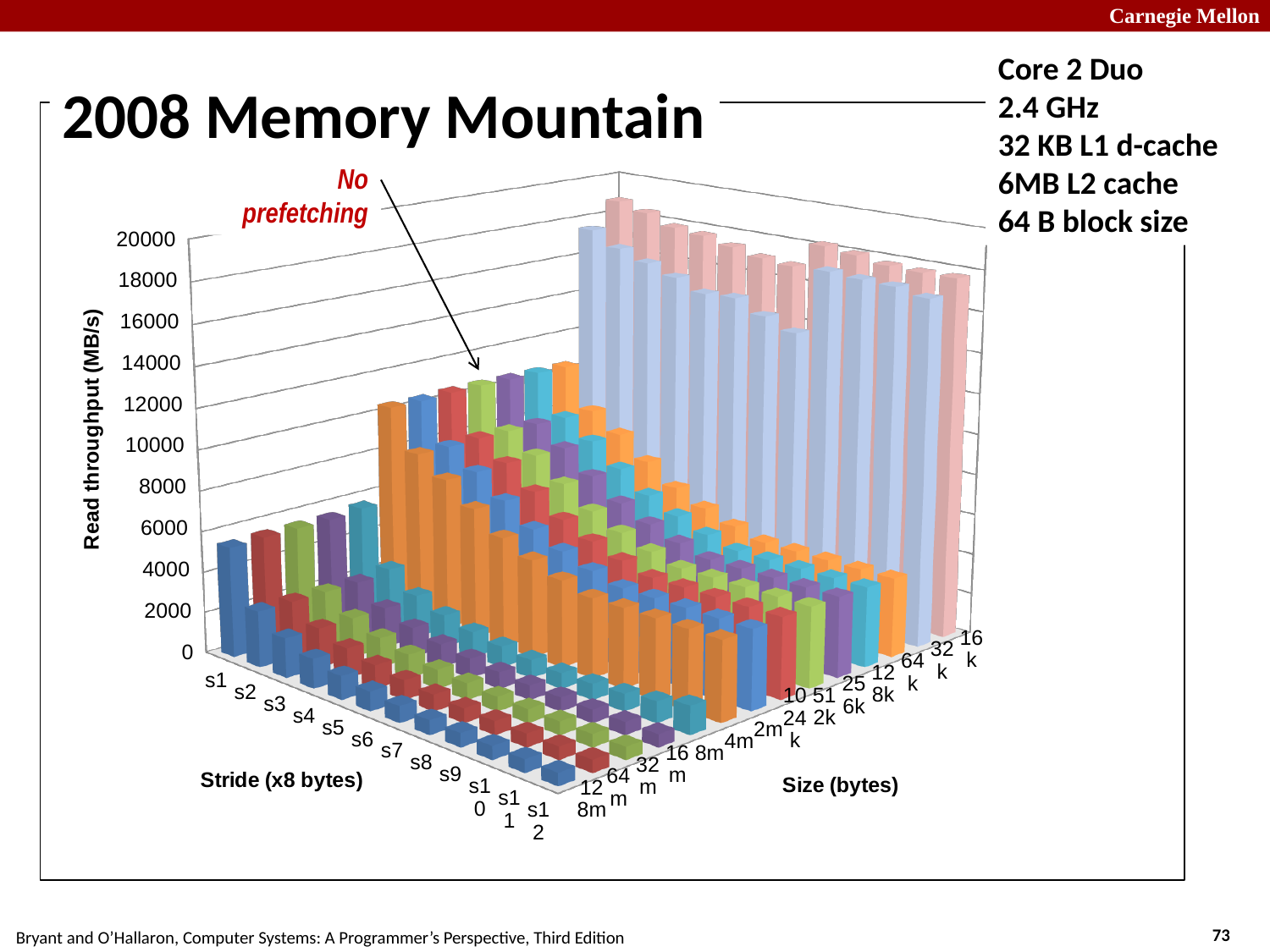
Is the read throughput for stride s12 at the largest size (front-right corner bar) greater or less than 2000? less Which is larger: the read throughput at stride s1 for size 16k, or at stride s1 for the largest size (front-left bar)? size 16k What is the title of the chart on the slide? 2008 Memory Mountain Is the read throughput for stride s1 at size 16k greater or less than 18000? greater What kind of chart is shown on the slide? 3D bar chart What is the label of the vertical axis? Read throughput (MB/s) What is the highest tick value shown on the read throughput axis? 20000 How many stride categories (s1 through s12) are shown on the stride axis? 12 What is the interval between consecutive ticks on the read throughput axis? 2000 What is the label of the axis running along the right side of the chart base? Size (bytes) Is the read throughput for stride s1 at the largest size (front-left bar) greater or less than 6000? less For the largest size (front row of bars), does read throughput rise or fall as the stride increases from s1 to s12? fall